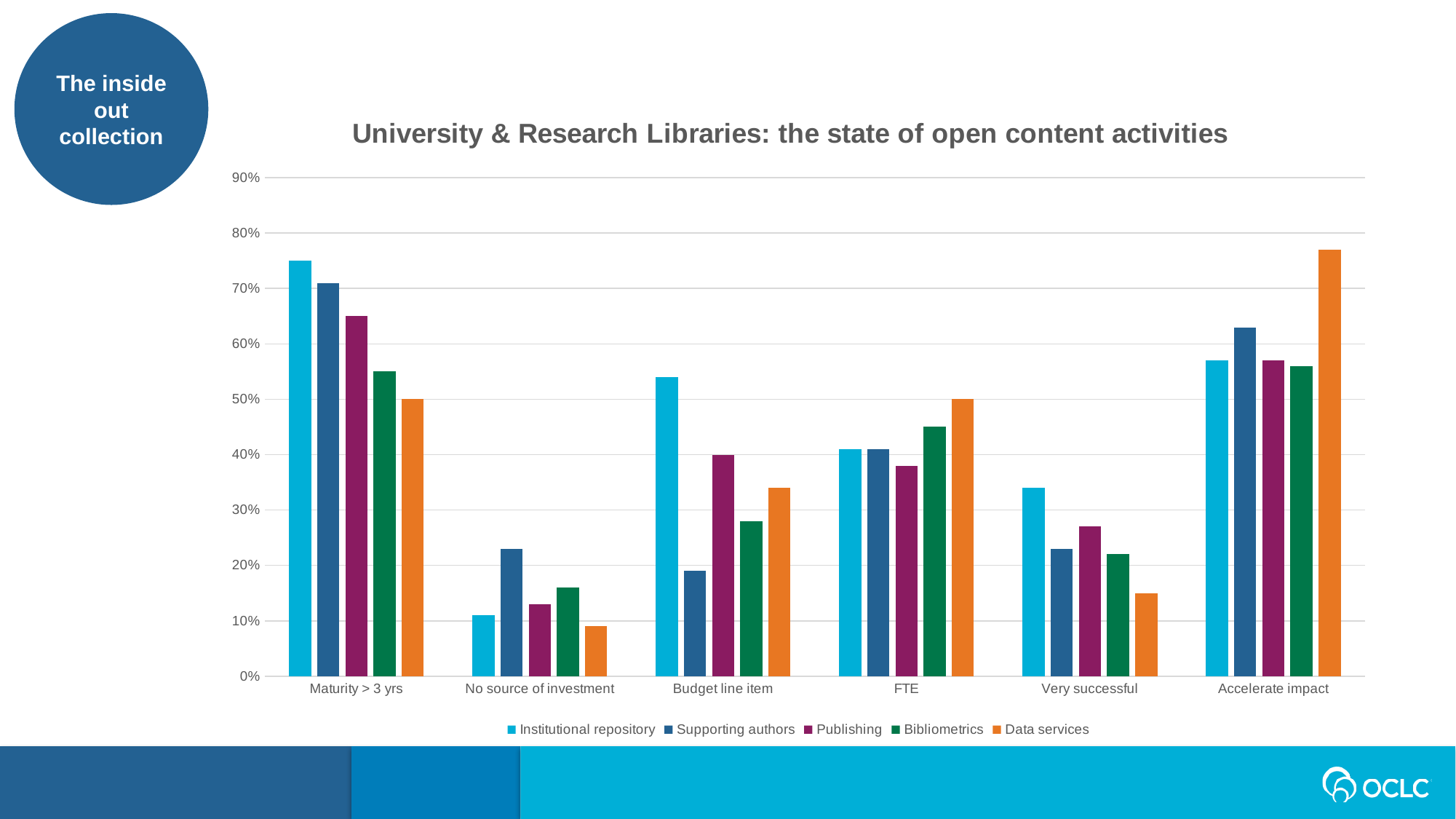
Is the value for Supporting authors at No source of investment greater or less than 20%? greater In which category is the Institutional repository bar the lowest? No source of investment What kind of chart is shown on the slide? bar chart Which series has the highest bar in the Maturity > 3 yrs category? Institutional repository Is the value for Institutional repository at Maturity > 3 yrs greater or less than 70%? greater How many series does the legend list? 5 What colour represents Data services in the legend? orange In which category is the Data services bar the highest? Accelerate impact How many categories are shown along the x axis? 6 For Accelerate impact, which is larger: Data services or Institutional repository? Data services Is the value for Bibliometrics at Very successful greater or less than 30%? less For Budget line item, which is larger: Institutional repository or Supporting authors? Institutional repository